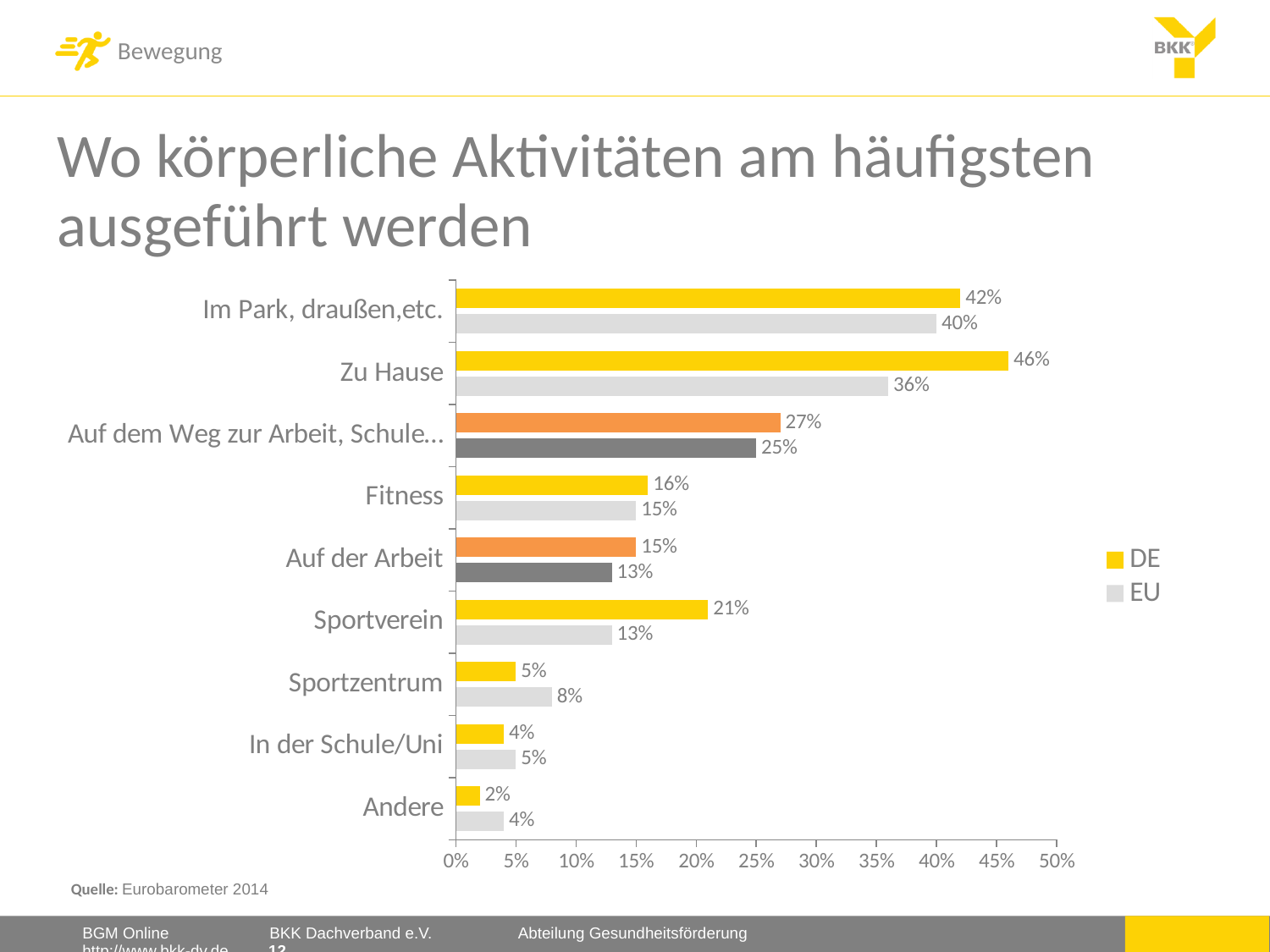
What is the difference between the DE and EU values for Zu Hause? 10% What is the EU value for Im Park, draußen,etc.? 40% What is the EU value for Sportverein? 13% What kind of chart is shown on the slide? Bar chart How many series does the legend list? 2 Which category has the lowest EU value? Andere Which category has the highest DE value? Zu Hause What is the source given below the chart? Eurobarometer 2014 What is the difference between the DE and EU values for Sportverein? 8% Which is larger for Sportzentrum, the DE value or the EU value? EU How many categories are shown on the chart? 9 What is the DE value for Zu Hause? 46%